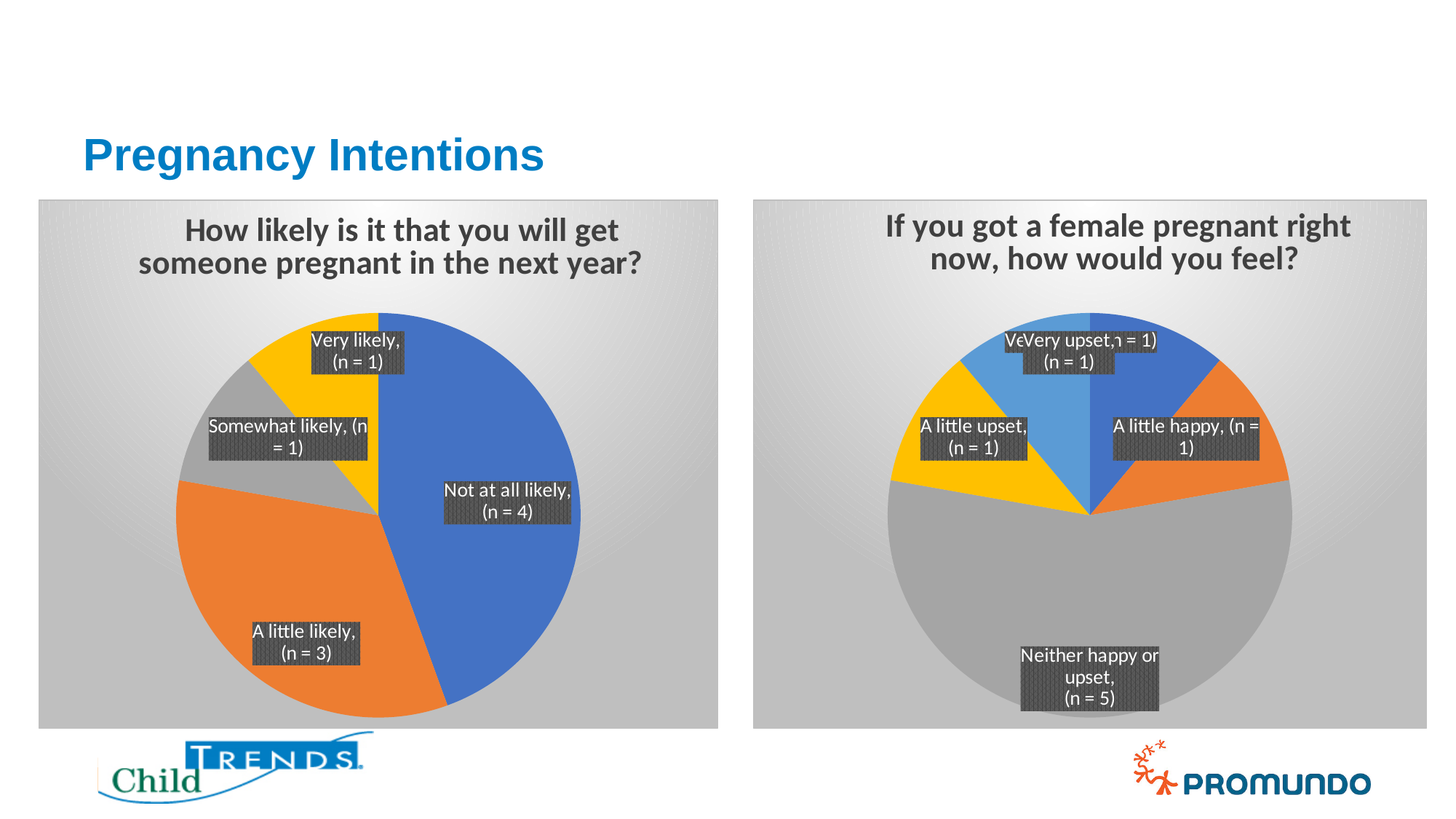
In the chart titled "How likely is it that you will get someone pregnant in the next year?", what share of the total responses does "Not at all likely" represent? 4 out of 9 In the chart titled "How likely is it that you will get someone pregnant in the next year?", how many categories are shown? 4 In the chart titled "How likely is it that you will get someone pregnant in the next year?", what is the difference between "Not at all likely" and "A little likely"? 1 What type of chart is used on the right side of the slide? Pie chart In the chart titled "How likely is it that you will get someone pregnant in the next year?", which category has the largest slice? Not at all likely In the chart titled "How likely is it that you will get someone pregnant in the next year?", what is the value for "A little likely"? n = 3 In the chart titled "If you got a female pregnant right now, how would you feel?", what is the difference between "Neither happy or upset" and "A little happy"? 4 In the chart titled "If you got a female pregnant right now, how would you feel?", what is the value for "Neither happy or upset"? n = 5 In the chart titled "How likely is it that you will get someone pregnant in the next year?", what is the value for "Not at all likely"? n = 4 In the chart titled "How likely is it that you will get someone pregnant in the next year?", which is larger: "A little likely" or "Very likely"? A little likely In the chart titled "How likely is it that you will get someone pregnant in the next year?", what colour is the "Very likely" slice? Yellow In the chart titled "If you got a female pregnant right now, how would you feel?", which category has the largest slice? Neither happy or upset